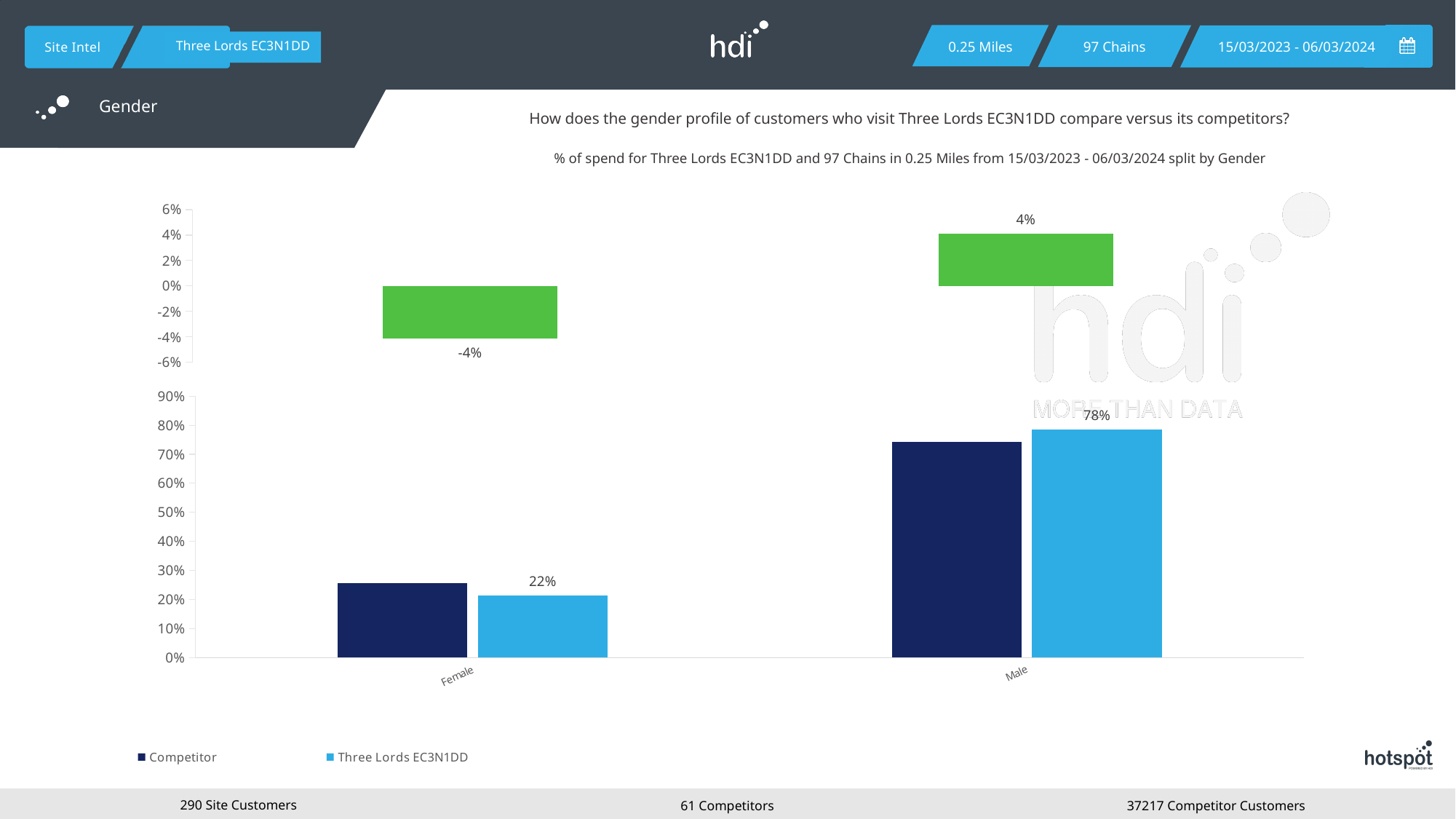
In the bottom chart, for Female, which is larger: the Competitor bar or the Three Lords EC3N1DD bar? Competitor How many gender categories are shown on the x axis of the bottom chart? 2 What type of chart is the bottom chart? Bar chart In the bottom chart, is the Competitor value for Male greater or less than 80%? less In the bottom chart, is the Competitor value for Female greater or less than 20%? greater In the bottom chart, what is the value for Three Lords EC3N1DD for Male? 78% In the bottom chart, what is the value for Three Lords EC3N1DD for Female? 22% In the top chart, what is the value shown for Female? -4% In the top chart, what is the value shown for Male? 4% How many series does the legend of the bottom chart list? 2 In the bottom chart, what is the difference between the Three Lords EC3N1DD values for Male and Female? 56% In the bottom chart, which gender category has the higher value for Three Lords EC3N1DD? Male